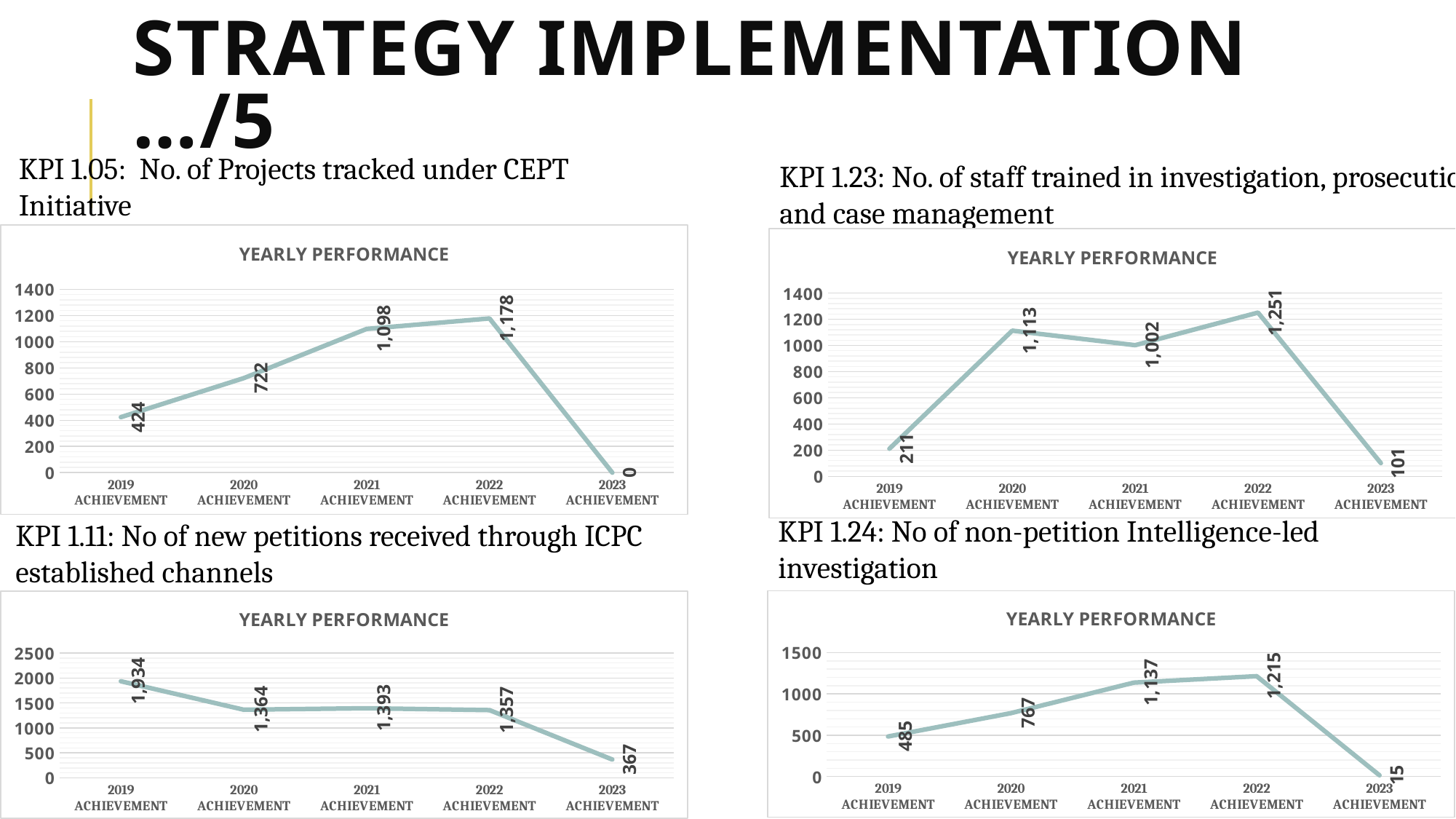
In the KPI 1.23 chart (top right), what is the value for 2019 ACHIEVEMENT? 211 In the KPI 1.23 chart (top right), which is larger, the 2020 value or the 2021 value? 2020 ACHIEVEMENT What type of chart is used for KPI 1.11 (bottom left)? Line chart How many data points are plotted in the KPI 1.24 chart (bottom right)? 5 In the KPI 1.24 chart (bottom right), what is the difference between the 2022 and 2021 values? 78 In the KPI 1.05 chart (top left), which year has the highest value? 2022 ACHIEVEMENT In the KPI 1.24 chart (bottom right), what is the value for 2020 ACHIEVEMENT? 767 In the KPI 1.11 chart (bottom left), which year has the highest value? 2019 ACHIEVEMENT In the KPI 1.23 chart (top right), which year has the lowest value? 2023 ACHIEVEMENT In the KPI 1.05 chart (top left), what is the value for 2021 ACHIEVEMENT? 1,098 In the KPI 1.11 chart (bottom left), what is the value for 2023 ACHIEVEMENT? 367 In the KPI 1.05 chart (top left), what is the difference between the 2022 and 2019 values? 754